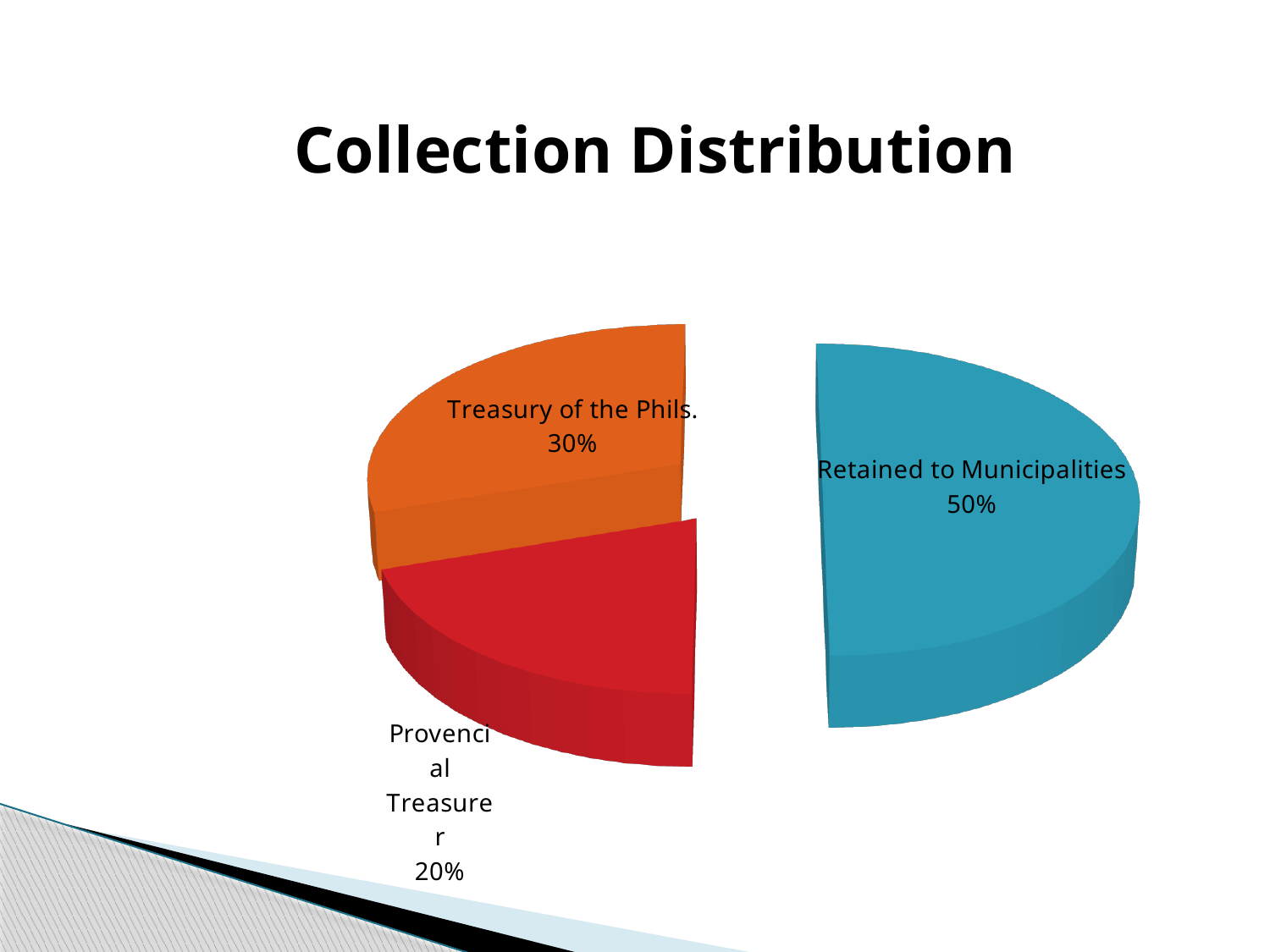
What colour is the Retained to Municipalities slice? blue What is the difference in percentage points between Retained to Municipalities and Treasury of the Phils.? 20% Which slice of the pie is the smallest? Provencial Treasurer What share of the pie does Provencial Treasurer have? 20% Which slice of the pie is the largest? Retained to Municipalities How many slices does the pie chart have? 3 What share of the pie does Treasury of the Phils. have? 30% Which is larger, the share for Treasury of the Phils. or the share for Provencial Treasurer? Treasury of the Phils. What is the title of the chart? Collection Distribution What is the difference in percentage points between Treasury of the Phils. and Provencial Treasurer? 10% What share of the pie does Retained to Municipalities have? 50% What type of chart is shown on the slide? pie chart